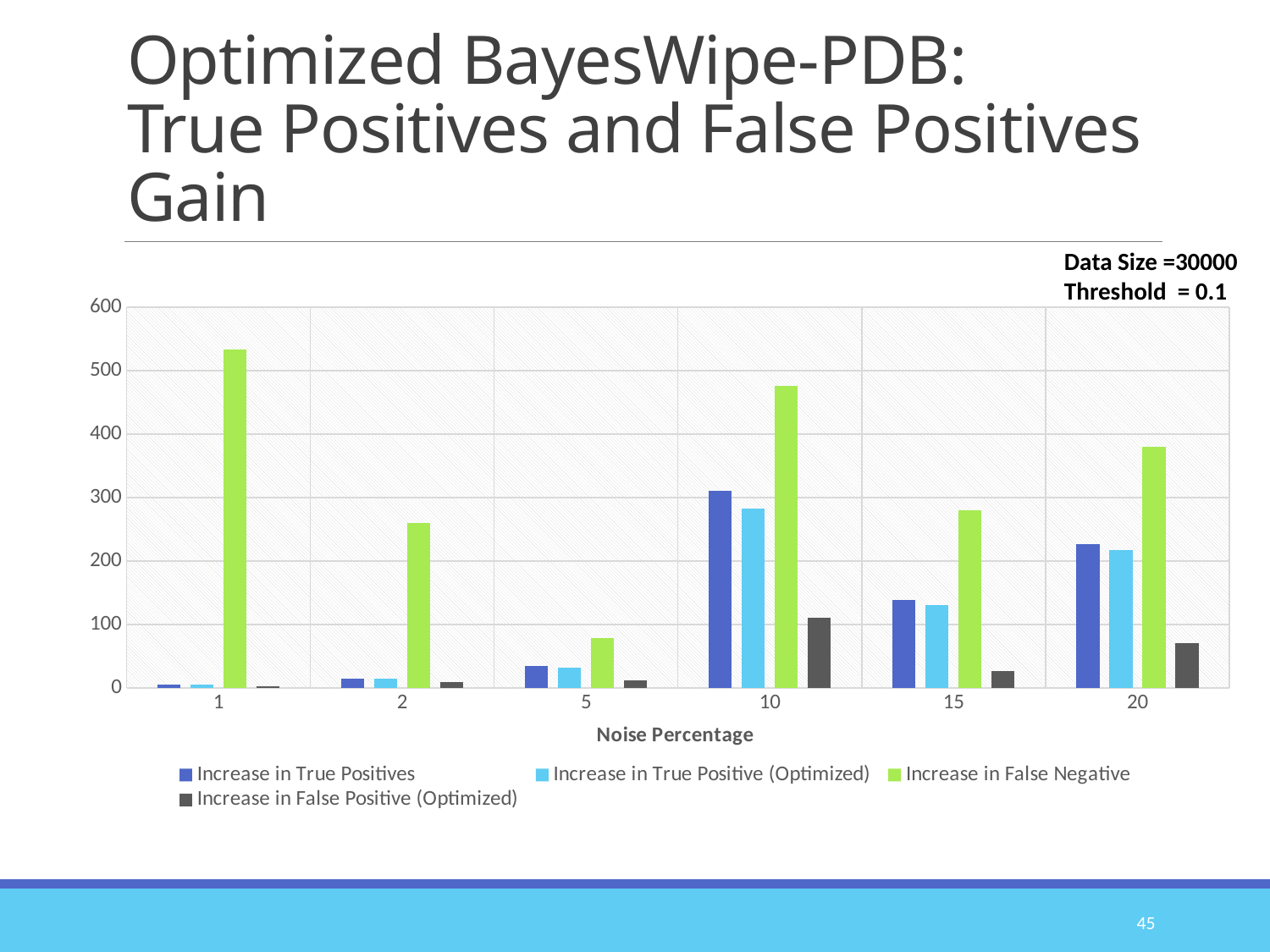
Is the Increase in True Positives at noise percentage 10 greater or less than 300? greater What kind of chart is shown on the slide? bar chart Is the Increase in False Positive (Optimized) at noise percentage 15 greater or less than 100? less At which noise percentage is the Increase in False Negative lowest? 5 What is the title of the x axis? Noise Percentage At which noise percentage is the Increase in False Negative highest? 1 How many noise percentage categories are shown on the x axis? 6 At noise percentage 10, which is larger: Increase in False Negative or Increase in True Positives? Increase in False Negative How many series does the legend list? 4 Is the Increase in False Negative at noise percentage 1 greater or less than 500? greater At which noise percentage is the Increase in True Positives highest? 10 Is the Increase in False Negative larger at noise percentage 2 or at noise percentage 5? 2